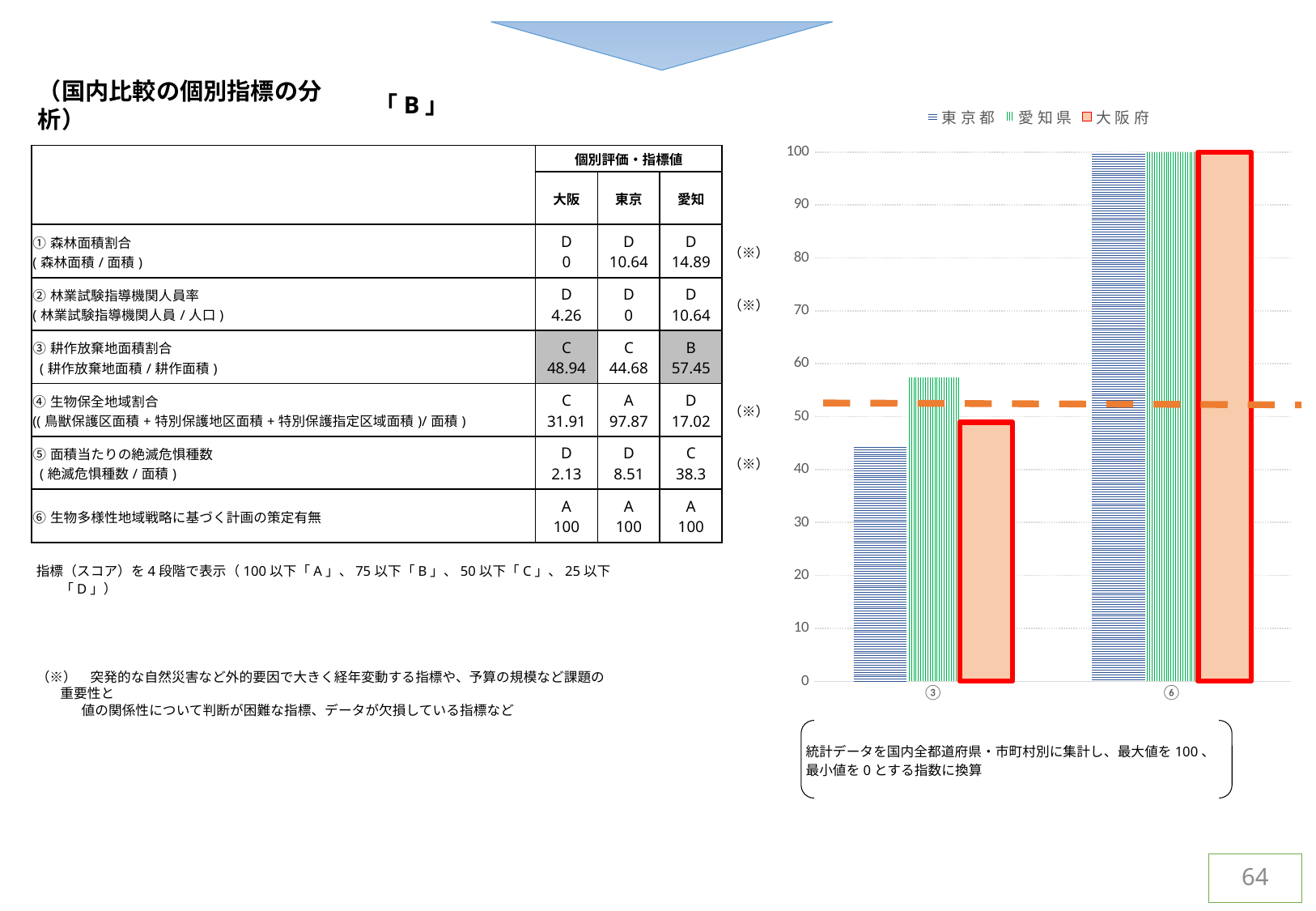
Is the value for 大阪府 at category ③ greater or less than 50? less Is the value for 東京都 at category ③ greater or less than 40? greater At category ③, which is larger: the value for 東京都 or the value for 大阪府? 大阪府 What kind of chart is shown on the right side of the slide? bar chart What is the value for 東京都 at category ⑥ in the bar chart? 100 How many series does the legend of the bar chart list? 3 Do the values for 大阪府 rise or fall from category ③ to category ⑥? rise What is the value for 大阪府 at category ⑥ in the bar chart? 100 How many categories are shown on the x axis of the bar chart? 2 Which series has the highest value at category ③ in the bar chart? 愛知県 Which series in the bar chart is outlined in red? 大阪府 Is the value for 愛知県 at category ③ greater or less than 50? greater